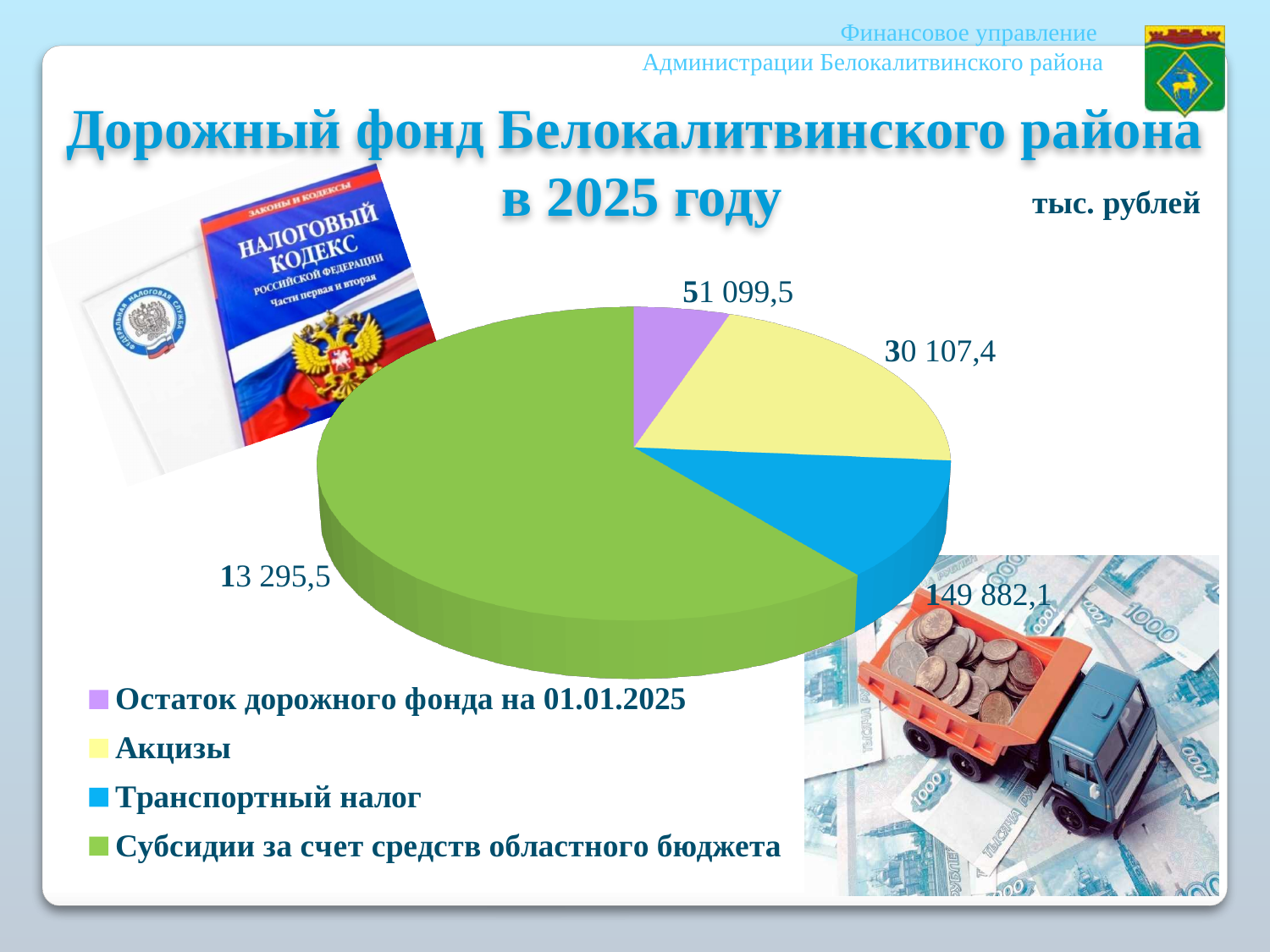
How many entries does the legend of the pie chart list? 4 What colour represents Транспортный налог in the pie chart? Blue What type of chart is shown on the slide? Pie chart What is the largest data label value printed on the pie chart? 149 882,1 Which category has the largest slice of the pie chart? Субсидии за счет средств областного бюджета Which slice is larger: Субсидии за счет средств областного бюджета or Акцизы? Субсидии за счет средств областного бюджета Which category has the smallest slice of the pie chart? Остаток дорожного фонда на 01.01.2025 How many slices does the pie chart have? 4 What is the smallest data label value printed on the pie chart? 13 295,5 In what unit are the values of the chart given, according to the slide? тыс. рублей